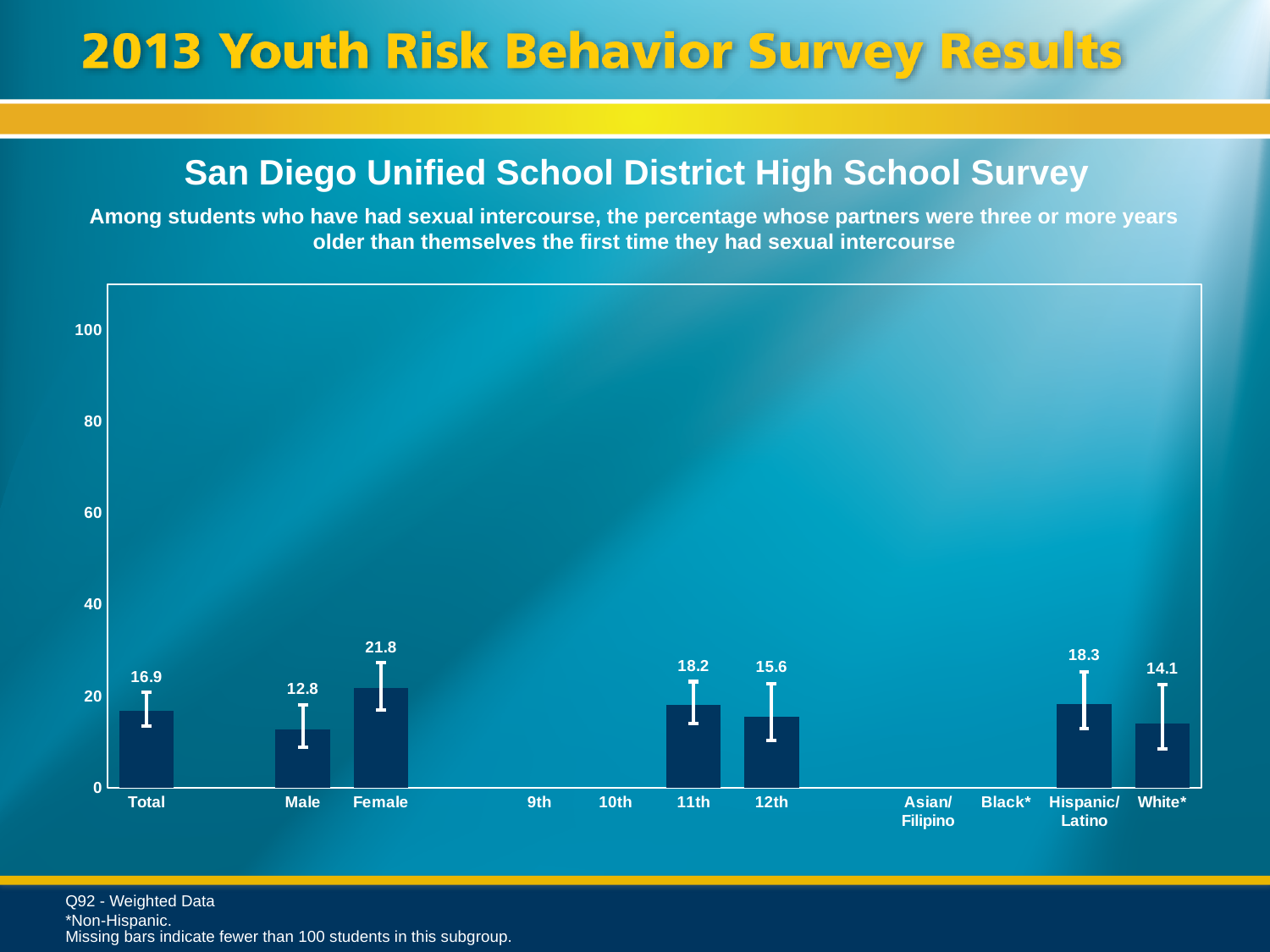
What kind of chart is shown? bar chart What is the value for 12th grade? 15.6 Is the value for White* greater or less than 20? less How many categories have a bar plotted? 7 What is the value for Female? 21.8 Which category with a bar has the lowest value? Male What is the value for Total? 16.9 What is the value for Hispanic/Latino? 18.3 Which categories have no bar shown? 9th, 10th, Asian/Filipino, Black* Which category has the highest value? Female What is the difference between the Female and Male values? 9.0 Which is larger, the value for 11th grade or 12th grade? 11th